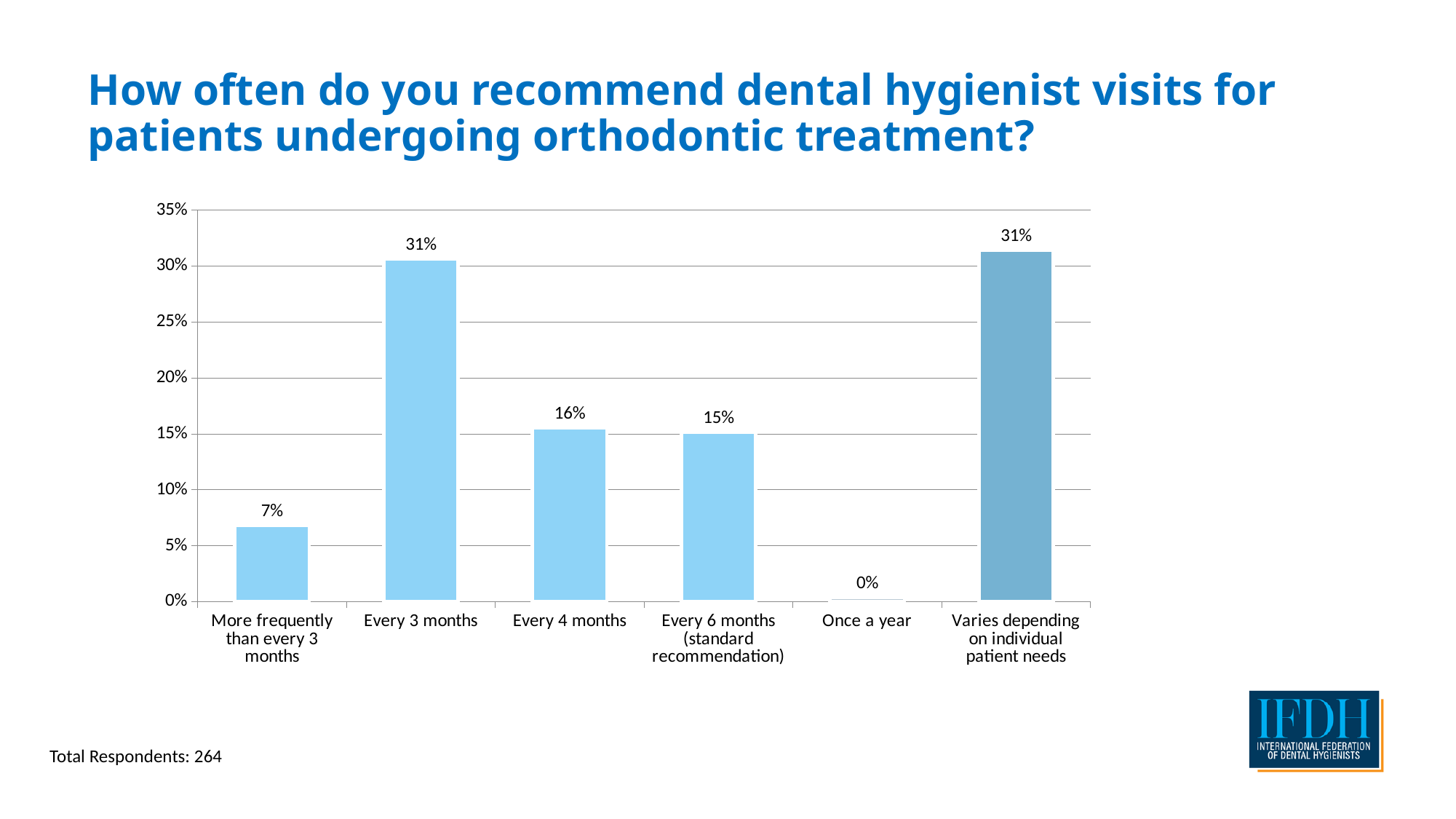
What is the value for 'More frequently than every 3 months'? 7% How many total respondents are noted on the slide? 264 What is the difference between the values for 'Every 3 months' and 'Every 4 months'? 15% Is the value for 'Varies depending on individual patient needs' greater or less than 25%? greater Which category has the lowest value? Once a year How many categories are shown on the x axis? 6 What percentage of respondents recommend dental hygienist visits every 3 months? 31% Which is larger: the value for 'Every 4 months' or 'More frequently than every 3 months'? Every 4 months What percentage of respondents recommend visits once a year? 0% What kind of chart is shown on the slide? bar chart What percentage of respondents chose 'Every 6 months (standard recommendation)'? 15% What is the value for 'Every 4 months'? 16%